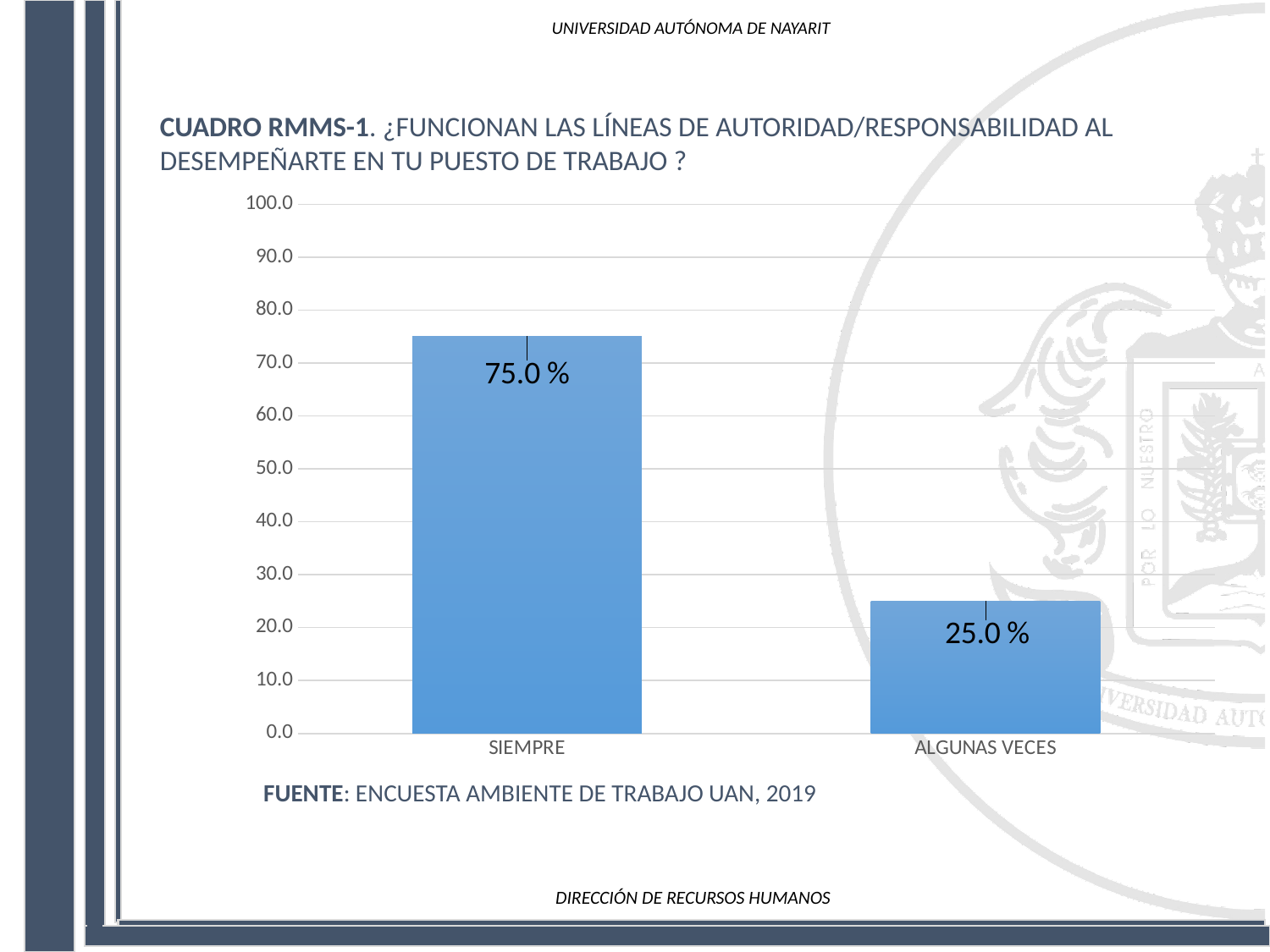
How many categories are shown on the chart? 2 What is the difference between the values for SIEMPRE and ALGUNAS VECES? 50.0 % What is the value for SIEMPRE? 75.0 % Which is larger, the value for SIEMPRE or the value for ALGUNAS VECES? SIEMPRE Which category has the highest value? SIEMPRE What kind of chart is shown on the slide? bar chart Is the value for ALGUNAS VECES greater or less than 30.0? less What is the value for ALGUNAS VECES? 25.0 % What is the source cited below the chart? ENCUESTA AMBIENTE DE TRABAJO UAN, 2019 Is the value for SIEMPRE greater or less than 70.0? greater What is the maximum value shown on the vertical axis? 100.0 Which category has the lowest value? ALGUNAS VECES